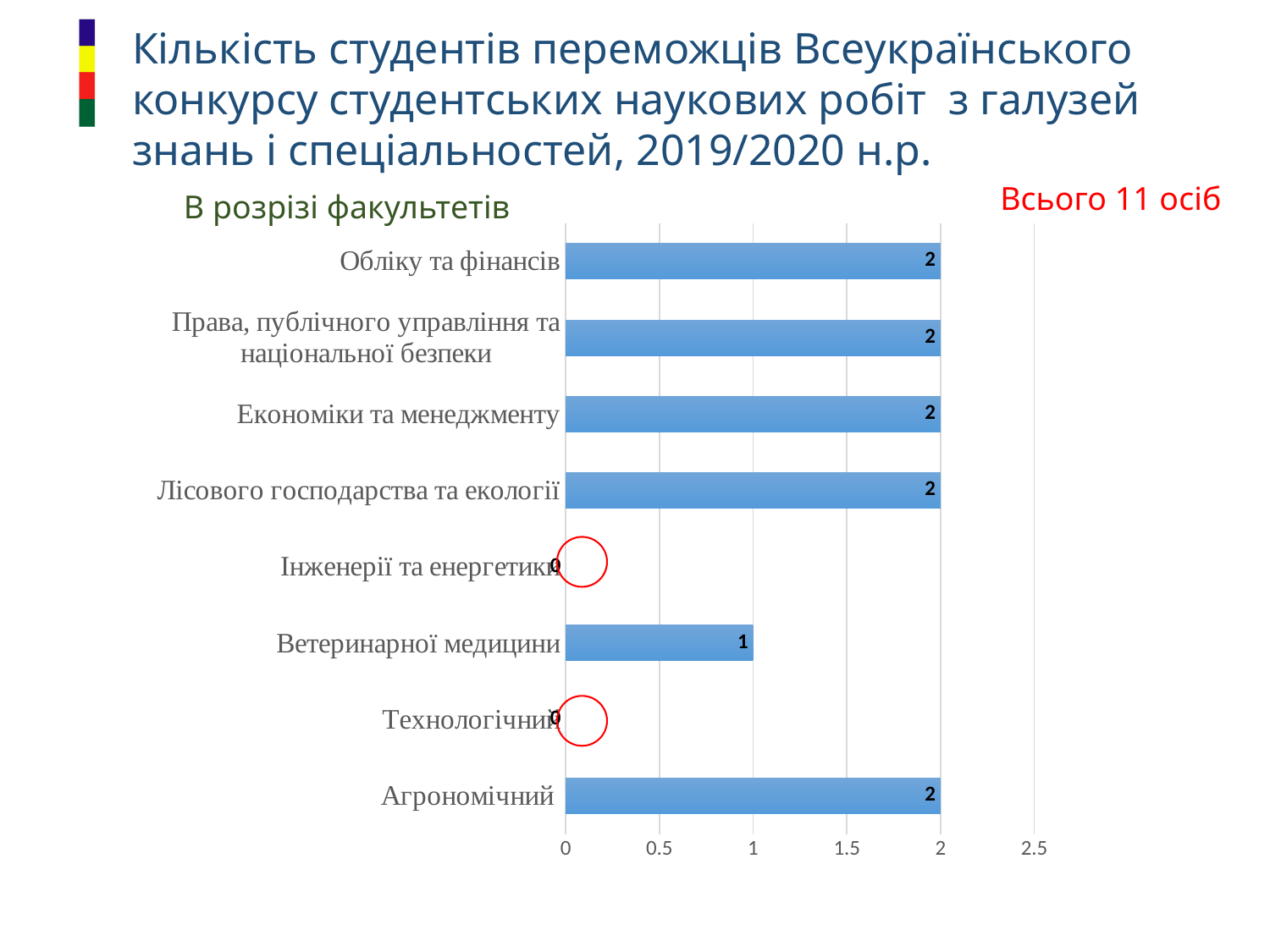
Which is larger, the value for Агрономічний or the value for Ветеринарної медицини? Агрономічний What is the value for Обліку та фінансів? 2 What is the value for Ветеринарної медицини? 1 How many categories have a value of 0? 2 What is the value for Інженерії та енергетики? 0 What is the value for Агрономічний? 2 Is the value for Ветеринарної медицини greater or less than 1.5? less According to the slide, what is the total number of students (Всього)? 11 осіб What is the difference between the value for Економіки та менеджменту and the value for Ветеринарної медицини? 1 What kind of chart is shown on the slide? bar chart How many categories (faculties) are shown in the chart? 8 What is the value for Технологічний? 0